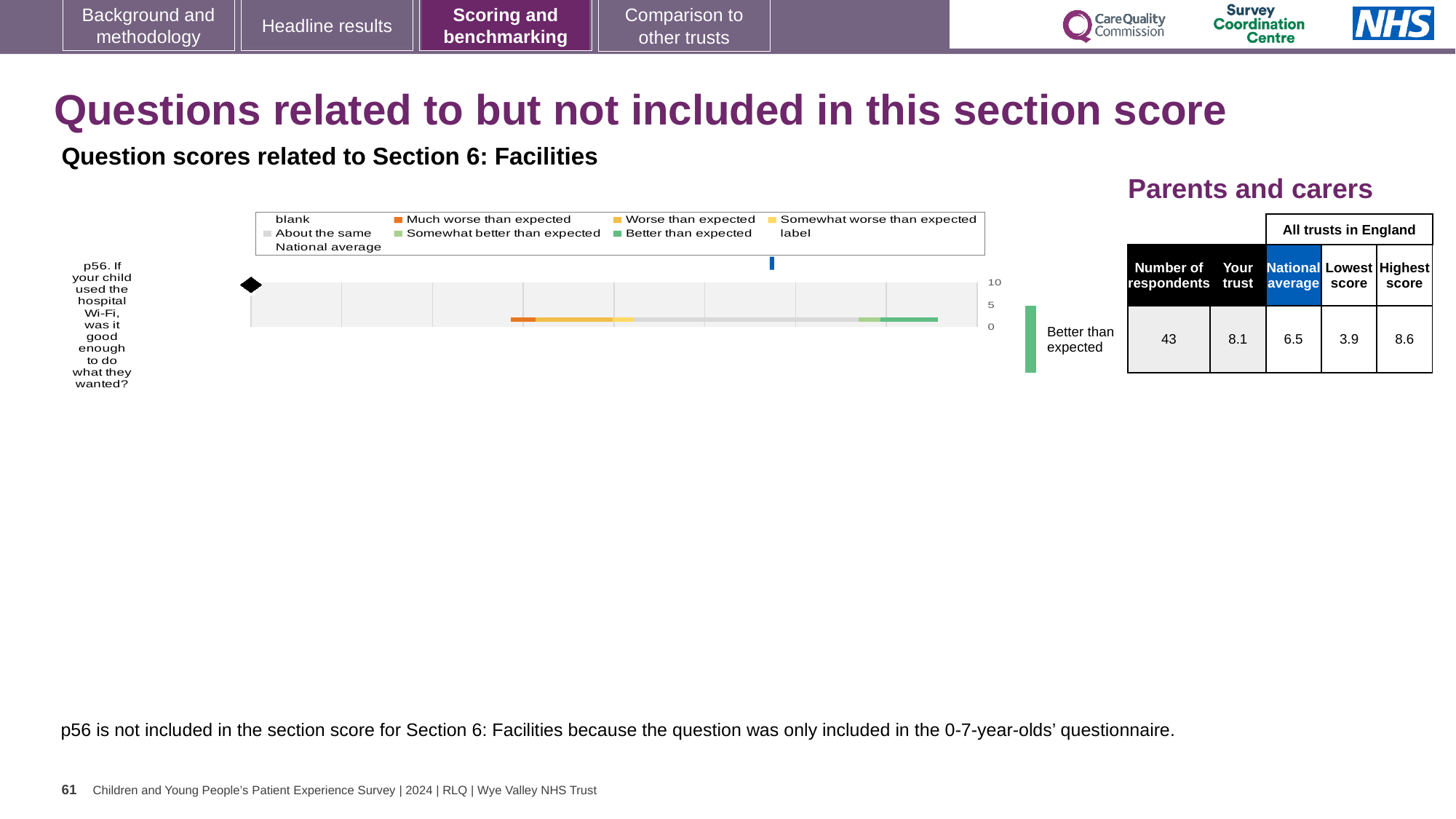
What is the lowest score among all trusts in England for p56? 3.9 What kind of chart is used to show the p56 question score? bar chart Is the trust's score for p56 greater or less than 5? greater What is the national average score for p56? 6.5 What is the difference between the highest and lowest trust scores for p56? 4.7 How many respondents answered p56? 43 What is the highest score among all trusts in England for p56? 8.6 What is the difference between the trust's score and the national average for p56? 1.6 How many survey questions are plotted on the chart? 1 What rating category is shown beside the chart for p56? Better than expected What is the 'Your trust' score for p56 (hospital Wi-Fi)? 8.1 Which is higher for p56: the trust's score or the national average? Your trust